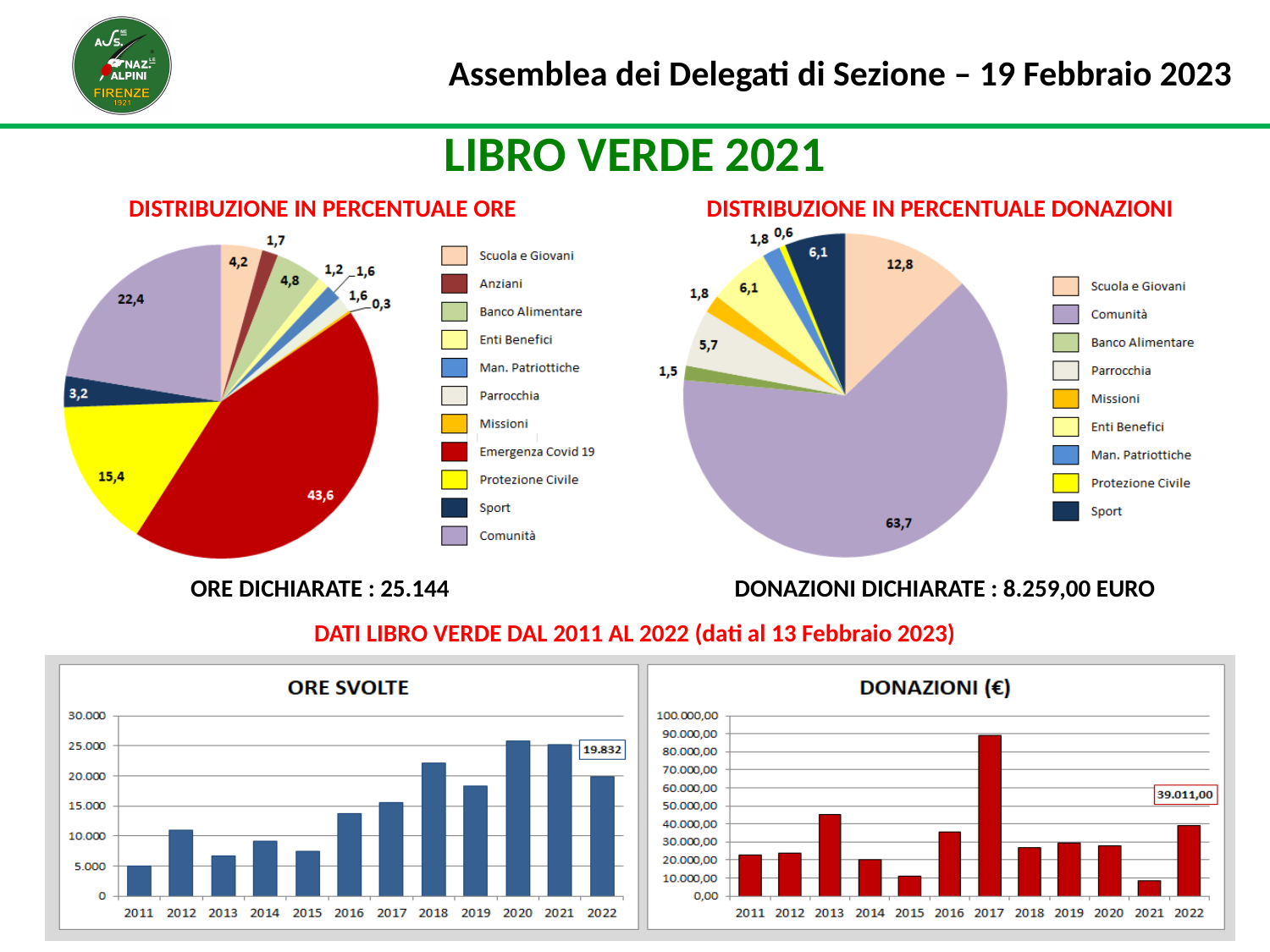
In the 'ORE SVOLTE' chart, what value is labelled for 2022? 19.832 In the 'ORE SVOLTE' chart, is the value for 2018 greater or less than 20.000? greater In the 'DISTRIBUZIONE IN PERCENTUALE DONAZIONI' pie chart, which is larger: Scuola e Giovani or Parrocchia? Scuola e Giovani In the 'DISTRIBUZIONE IN PERCENTUALE ORE' pie chart, what percentage is shown for Emergenza Covid 19? 43,6 In the 'DONAZIONI (€)' chart, which year has the highest bar? 2017 In the 'ORE SVOLTE' chart, which year has the lowest bar? 2011 How many categories does the legend of the 'DISTRIBUZIONE IN PERCENTUALE DONAZIONI' pie chart list? 9 In the 'DISTRIBUZIONE IN PERCENTUALE DONAZIONI' pie chart, what percentage is shown for Comunità? 63,7 In the 'DISTRIBUZIONE IN PERCENTUALE ORE' pie chart, which category has the smallest slice? Missioni In the 'DISTRIBUZIONE IN PERCENTUALE ORE' pie chart, what is the difference between the Comunità and Protezione Civile percentages? 7,0 In the 'DONAZIONI (€)' chart, what value is labelled for 2022? 39.011,00 What type of chart is 'DONAZIONI (€)'? bar chart